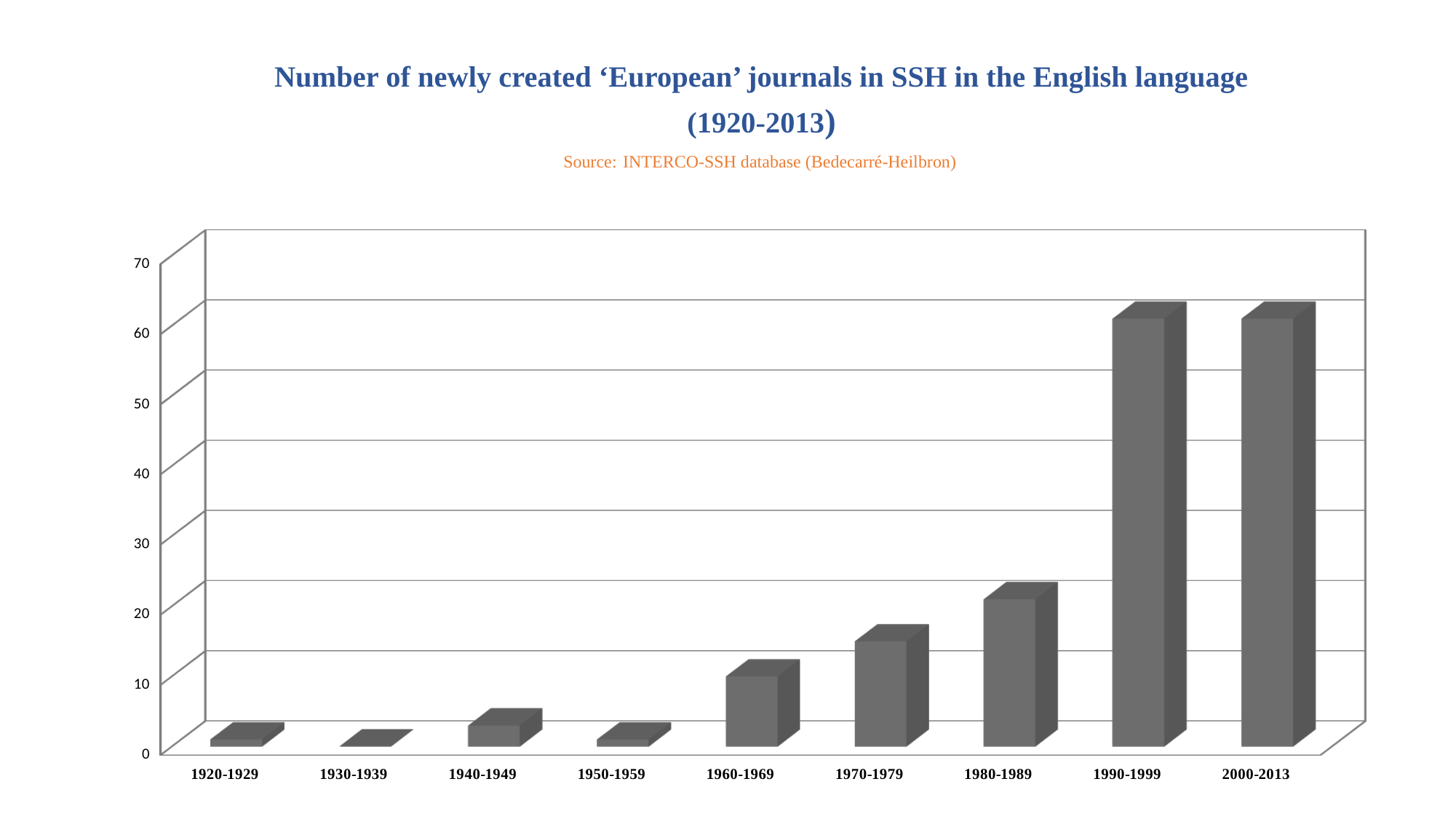
Is the value for 1940-1949 greater or less than 10? less What source is cited for the chart data? INTERCO-SSH database (Bedecarré-Heilbron) Which is larger, the value for 1980-1989 or the value for 1970-1979? 1980-1989 Is the value for 1980-1989 greater or less than 30? less Is the value for 1970-1979 greater or less than 10? greater How many time periods are shown on the x axis of the chart? 9 What kind of chart is shown on the slide? bar chart Do the values generally rise or fall from 1920-1929 to 2000-2013? rise What is the title of the chart? Number of newly created 'European' journals in SSH in the English language (1920-2013) Which is larger, the value for 1960-1969 or the value for 1940-1949? 1960-1969